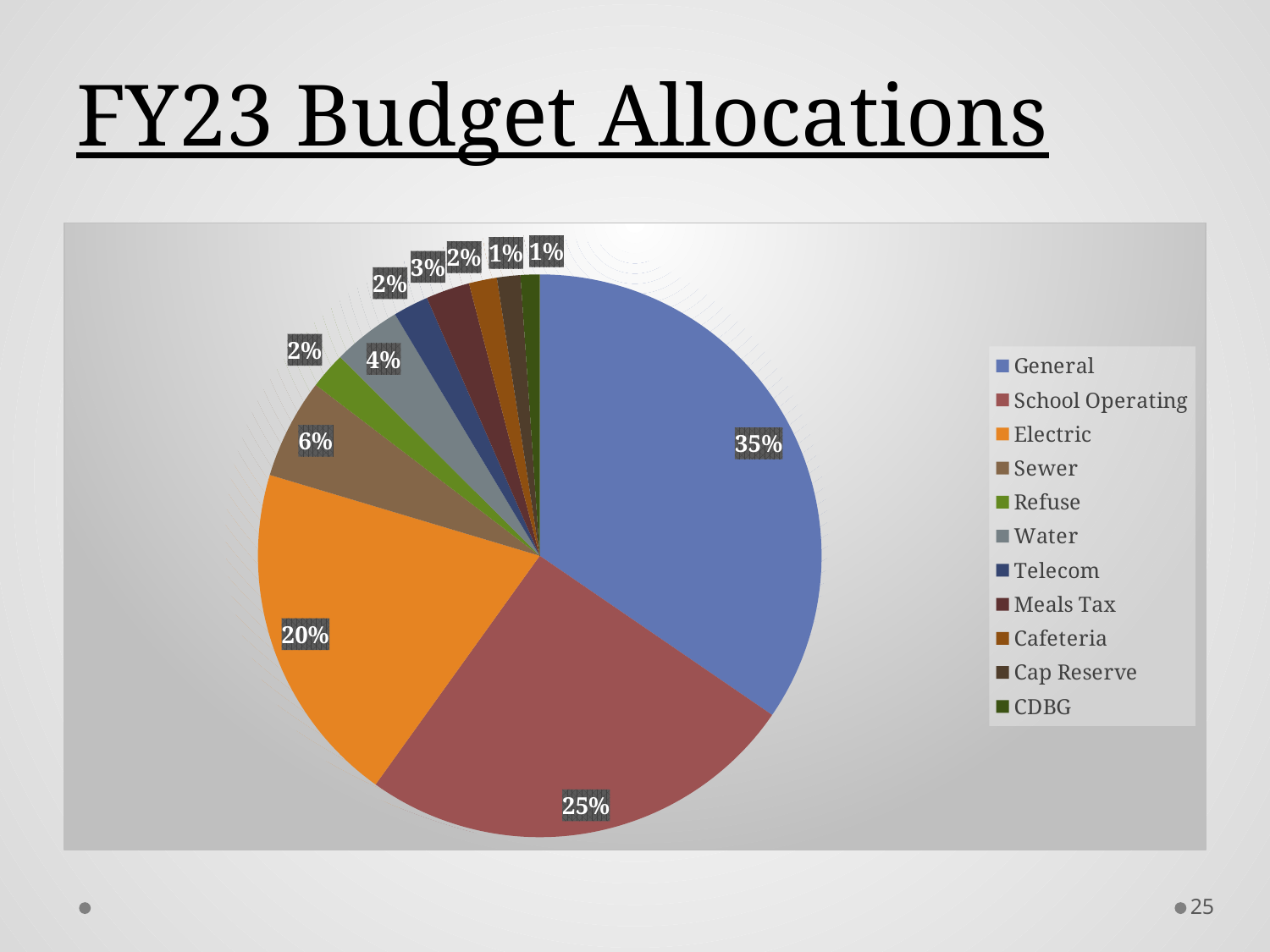
What percentage does the Water slice represent? 4% What is the difference in percentage points between the General and School Operating slices? 10 How many categories does the legend list? 11 What percentage does the Electric slice represent? 20% What share of the FY23 budget is allocated to General? 35% What is the title of the slide containing the chart? FY23 Budget Allocations Which is larger, the Electric slice or the Sewer slice? Electric What share of the FY23 budget is allocated to School Operating? 25% What colour is the General slice in the pie chart? Blue What kind of chart is shown on the slide? Pie chart What percentage does the Sewer slice represent? 6% Which category has the largest share of the FY23 budget? General